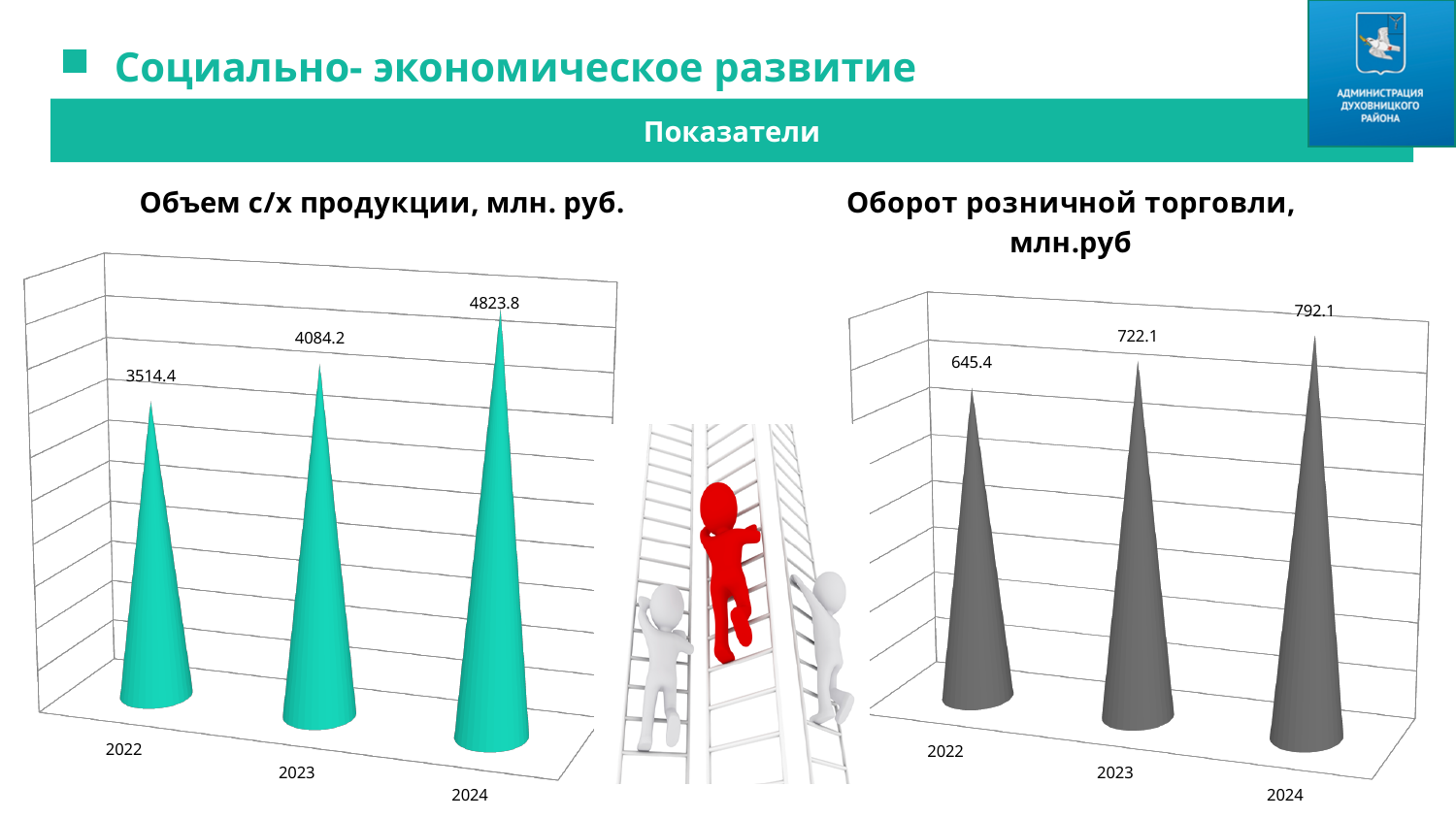
How many years are shown in the chart 'Оборот розничной торговли, млн.руб'? 3 In the chart 'Оборот розничной торговли, млн.руб', what is the difference between the 2023 and 2022 values? 76.7 In the chart 'Оборот розничной торговли, млн.руб', what is the value for 2022? 645.4 In the chart 'Оборот розничной торговли, млн.руб', do the values rise or fall from 2022 to 2024? Rise In the chart 'Оборот розничной торговли, млн.руб', which year has the lowest value? 2022 In the chart 'Объем с/х продукции, млн. руб.', what is the value for 2023? 4084.2 What kind of chart is 'Объем с/х продукции, млн. руб.'? Bar chart What colour are the bars in the chart 'Объем с/х продукции, млн. руб.'? Teal (green) In the chart 'Объем с/х продукции, млн. руб.', which year has the highest value? 2024 In the chart 'Оборот розничной торговли, млн.руб', what is the value for 2024? 792.1 In the chart 'Объем с/х продукции, млн. руб.', which is larger, the value for 2022 or the value for 2023? 2023 In the chart 'Объем с/х продукции, млн. руб.', what is the difference between the 2024 and 2022 values? 1309.4